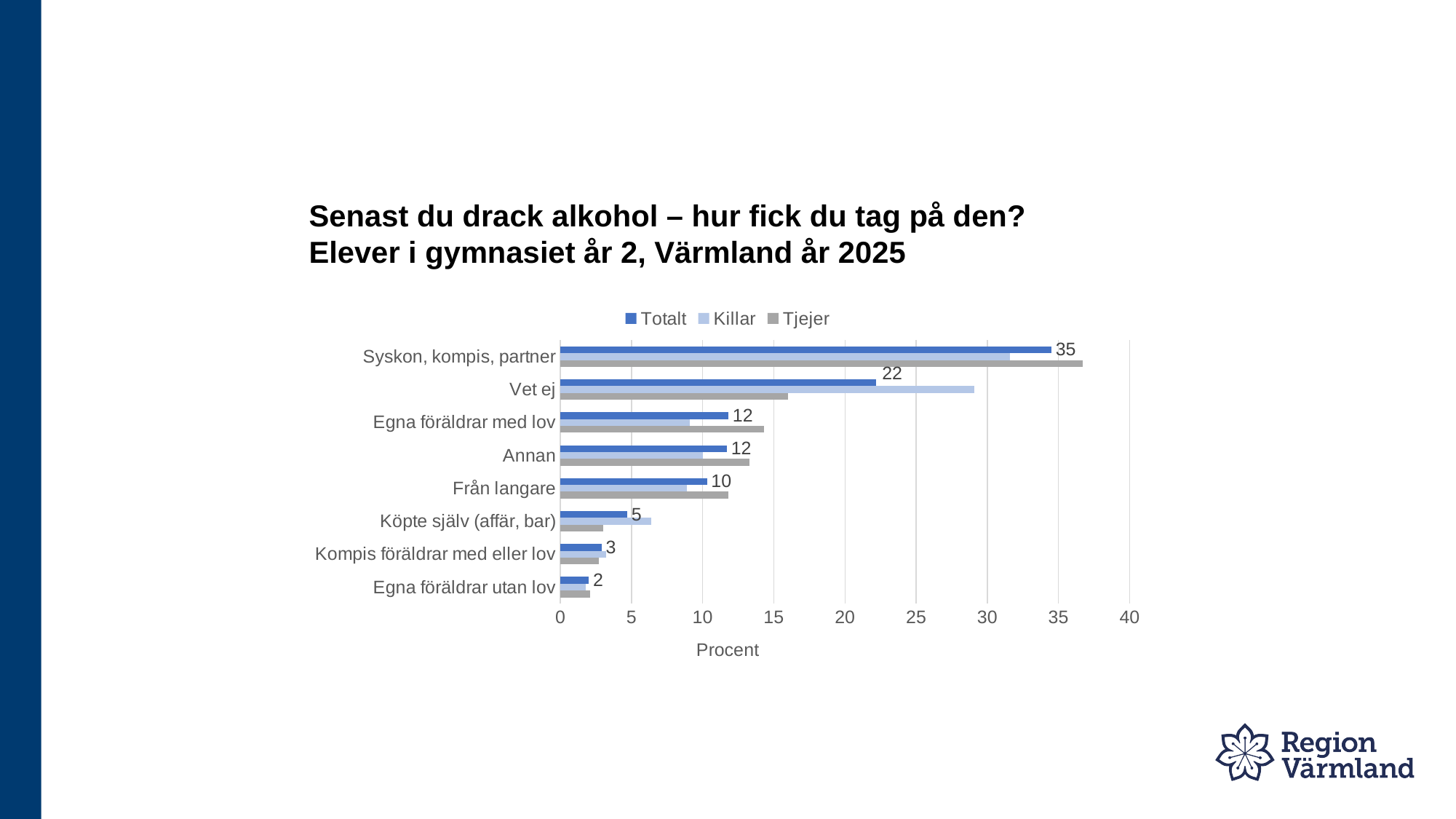
What is the Totalt value for "Vet ej"? 22 Which category has the highest Totalt value? Syskon, kompis, partner What is the Totalt value for "Från langare"? 10 How many series does the legend list? 3 Which category has the lowest Totalt value? Egna föräldrar utan lov What is the difference between the Totalt values for "Syskon, kompis, partner" and "Vet ej"? 13 Which has a larger Totalt value, "Vet ej" or "Från langare"? Vet ej How many categories are shown on the chart? 8 What is the Totalt value for "Egna föräldrar utan lov"? 2 What kind of chart is shown on the slide? Bar chart What is the Totalt value for "Syskon, kompis, partner"? 35 Is the Killar value for "Vet ej" greater or less than 25? greater